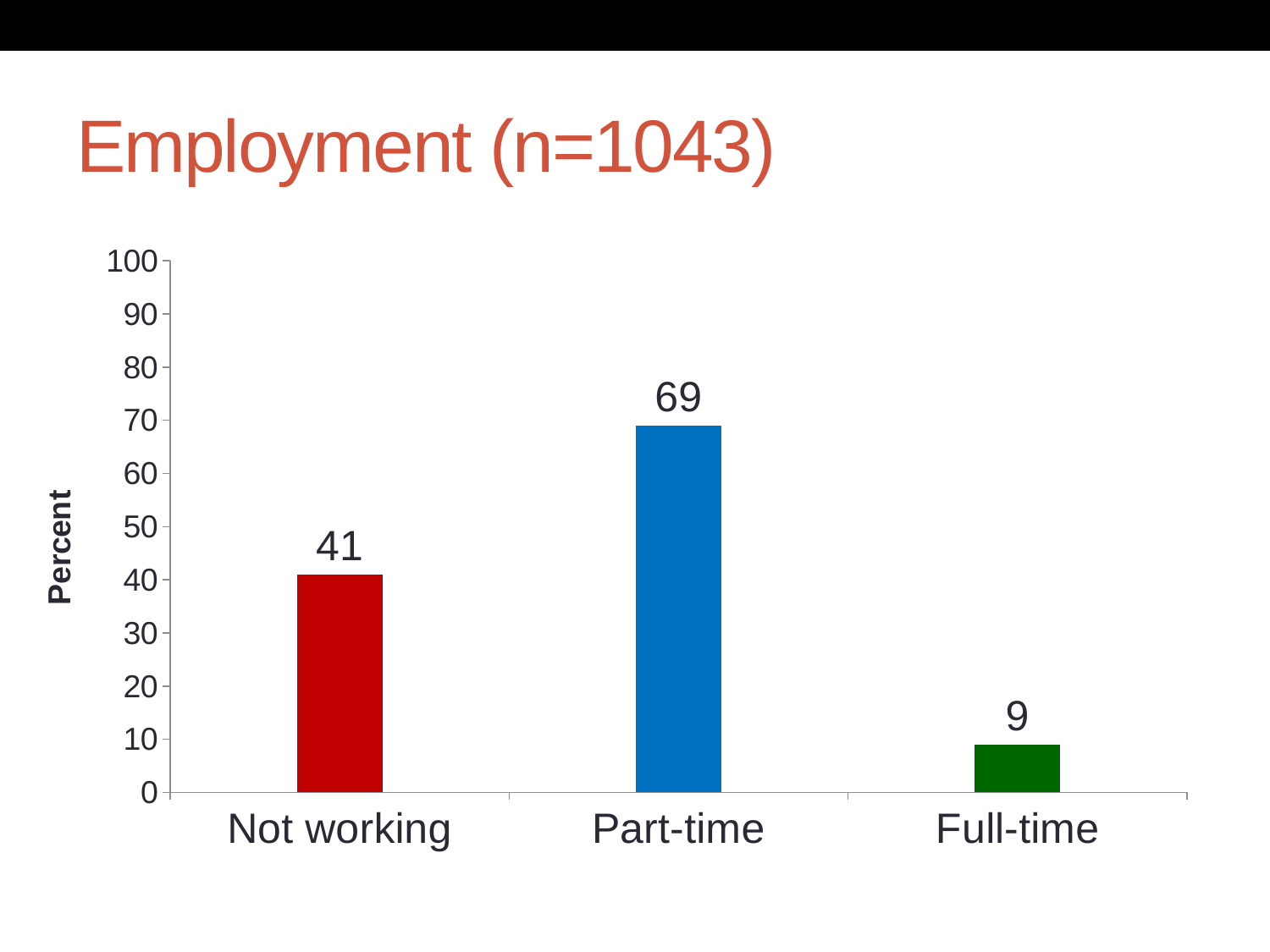
Is the value for Part-time greater or less than 60? greater Which category has the lowest value? Full-time What is the label of the y axis? Percent What is the value for Full-time? 9 How many categories are shown on the x axis? 3 What is the difference between the values for Not working and Full-time? 32 What kind of chart is shown on the slide? bar chart What is the value for Part-time? 69 Which is larger, the value for Not working or the value for Full-time? Not working What is the difference between the values for Part-time and Not working? 28 What is the value for Not working? 41 Which category has the highest value? Part-time